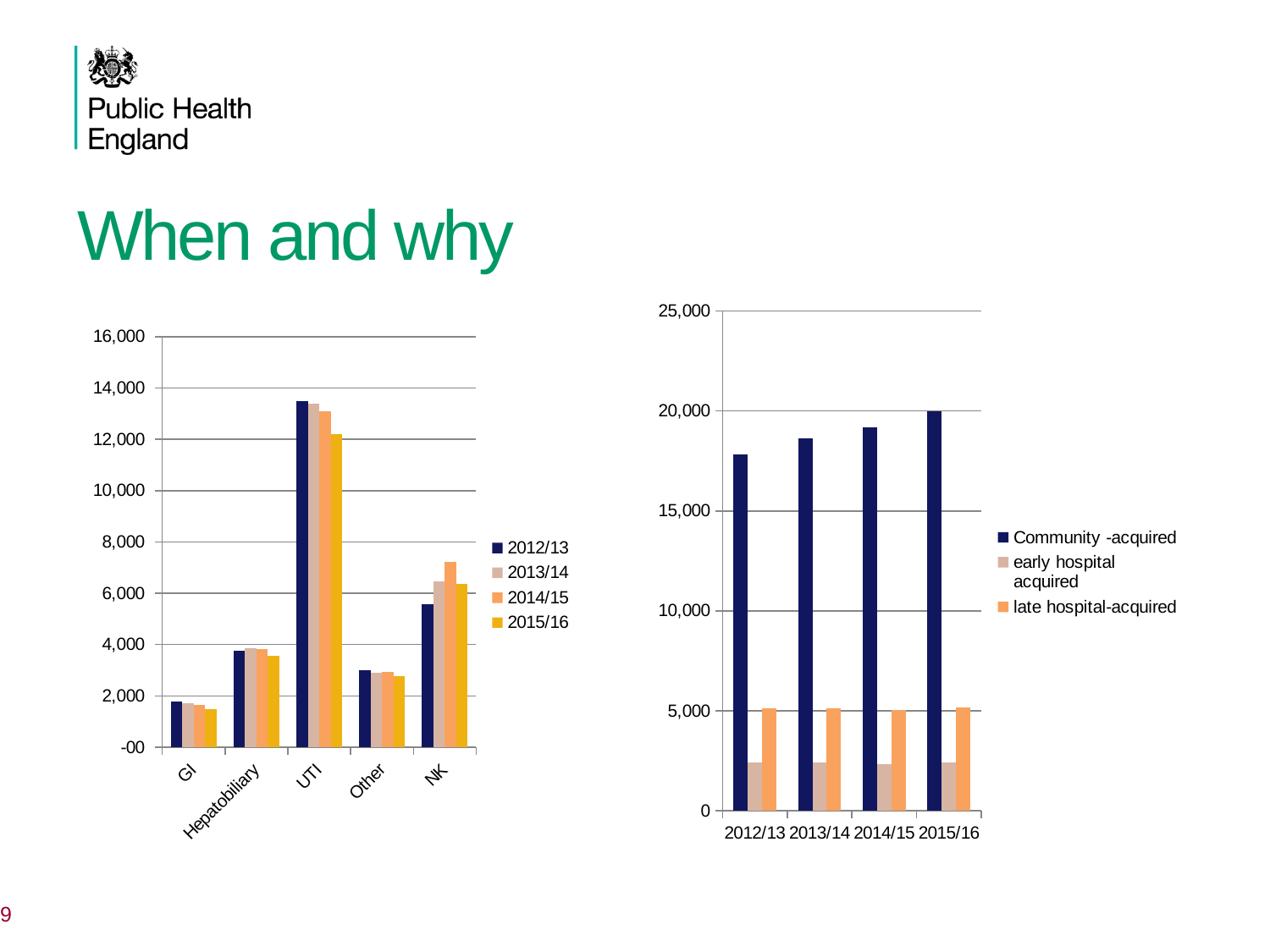
What kind of chart is the left chart on the slide? bar chart In the left chart, is the 2015/16 value for GI greater or less than 2,000? less How many series does the legend of the right chart list? 3 In the left chart, which category has the highest values? UTI How many series does the legend of the left chart list? 4 In the left chart, which is larger for NK: the 2014/15 value or the 2012/13 value? 2014/15 In the right chart, which series has the highest values in every year? Community -acquired How many categories are shown on the x axis of the left chart? 5 In the right chart, is the early hospital acquired value for 2015/16 greater or less than 5,000? less In the left chart, which category has the lowest values? GI In the left chart, is the 2012/13 value for UTI greater or less than 12,000? greater In the right chart, do the Community -acquired values rise or fall from 2012/13 to 2015/16? rise